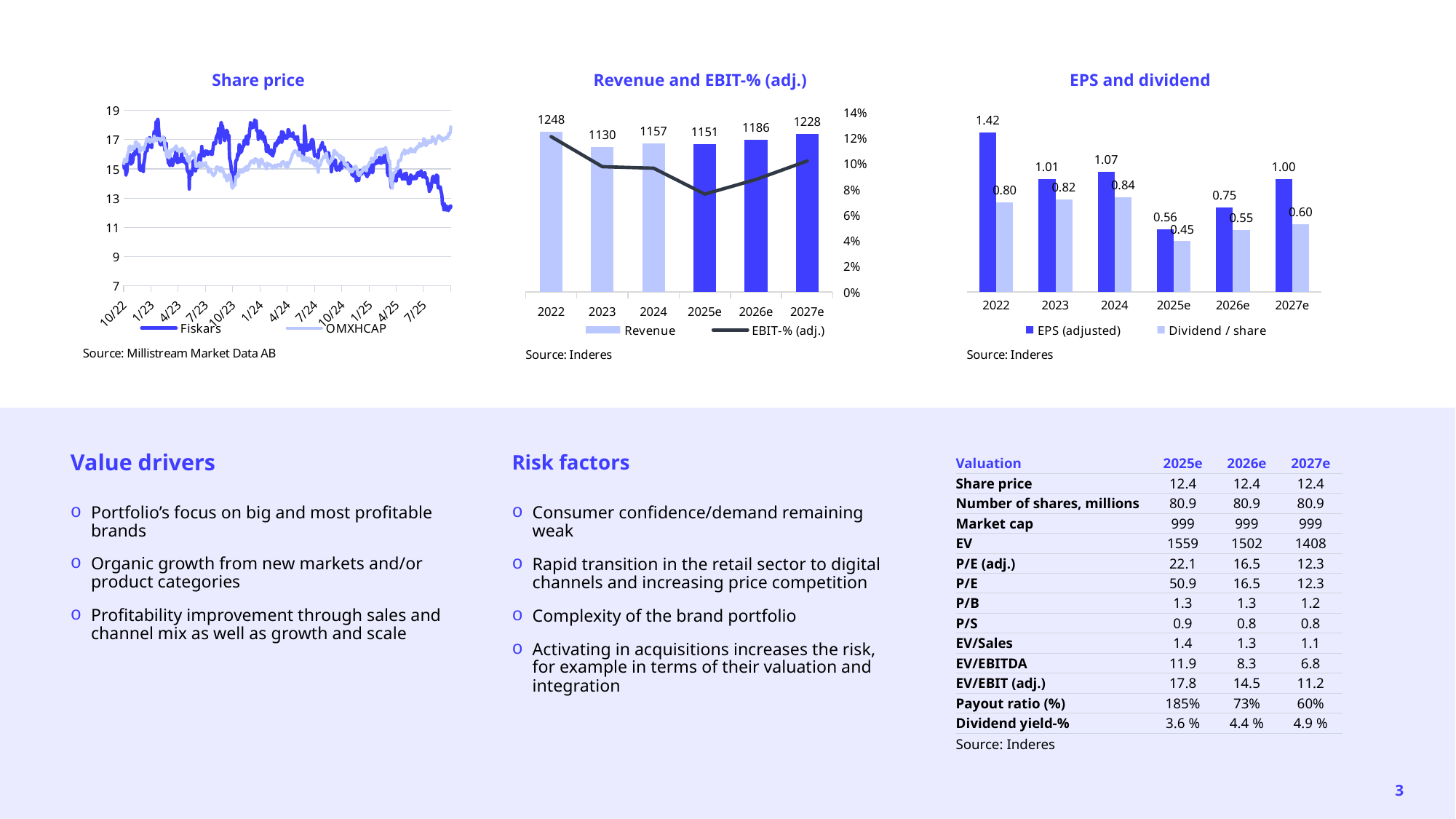
In the 'Revenue and EBIT-% (adj.)' chart, what is the difference between the revenue for 2027e and 2026e? 42 In the 'EPS and dividend' chart, what is the dividend per share for 2023? 0.82 In the 'EPS and dividend' chart, what is the difference between EPS (adjusted) and dividend per share in 2025e? 0.11 In the 'Revenue and EBIT-% (adj.)' chart, which year has the highest revenue? 2022 In the 'Revenue and EBIT-% (adj.)' chart, what is the revenue for 2024? 1157 In the 'Revenue and EBIT-% (adj.)' chart, how many series does the legend list? 2 In the 'Revenue and EBIT-% (adj.)' chart, which year has the lowest revenue? 2023 In the 'EPS and dividend' chart, what is the EPS (adjusted) for 2026e? 0.75 In the 'Revenue and EBIT-% (adj.)' chart, is the EBIT-% (adj.) value for 2022 greater or less than 10%? greater In the 'EPS and dividend' chart, does the dividend per share rise or fall from 2025e to 2027e? rise What kind of chart is the 'Share price' chart? line chart In the 'EPS and dividend' chart, which year has the lowest EPS (adjusted)? 2025e